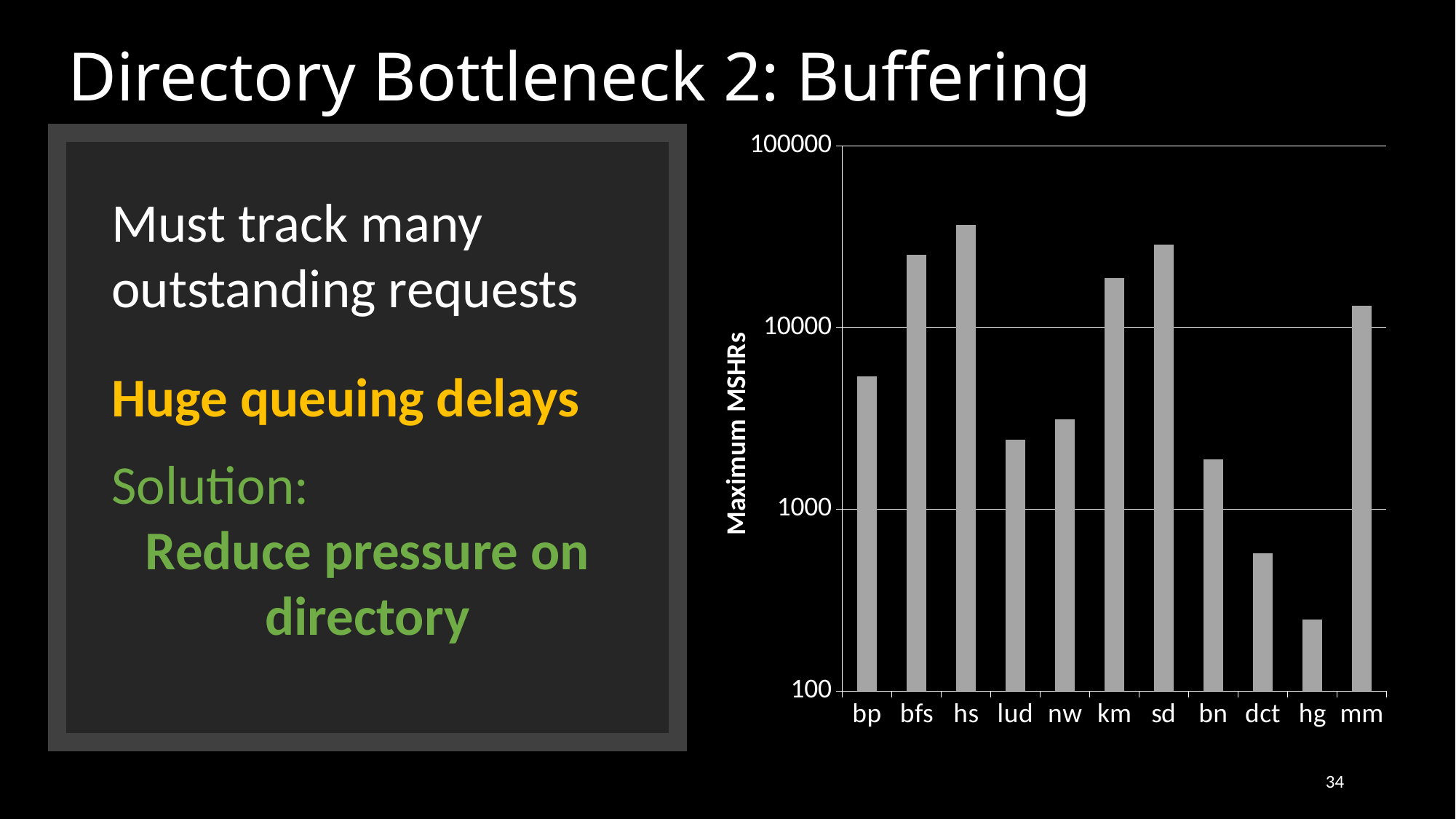
Which has a larger Maximum MSHRs value, hs or bp? hs Is the value for lud greater or less than 1000? greater Is the value for bp greater or less than 10000? less How many categories are shown on the x axis of the chart? 11 What kind of chart is shown on the slide? bar chart Which category has the lowest Maximum MSHRs value? hg Which has a larger Maximum MSHRs value, dct or hg? dct Which category has the highest Maximum MSHRs value? hs Is the value for dct greater or less than 1000? less What is the label of the y axis of the chart? Maximum MSHRs